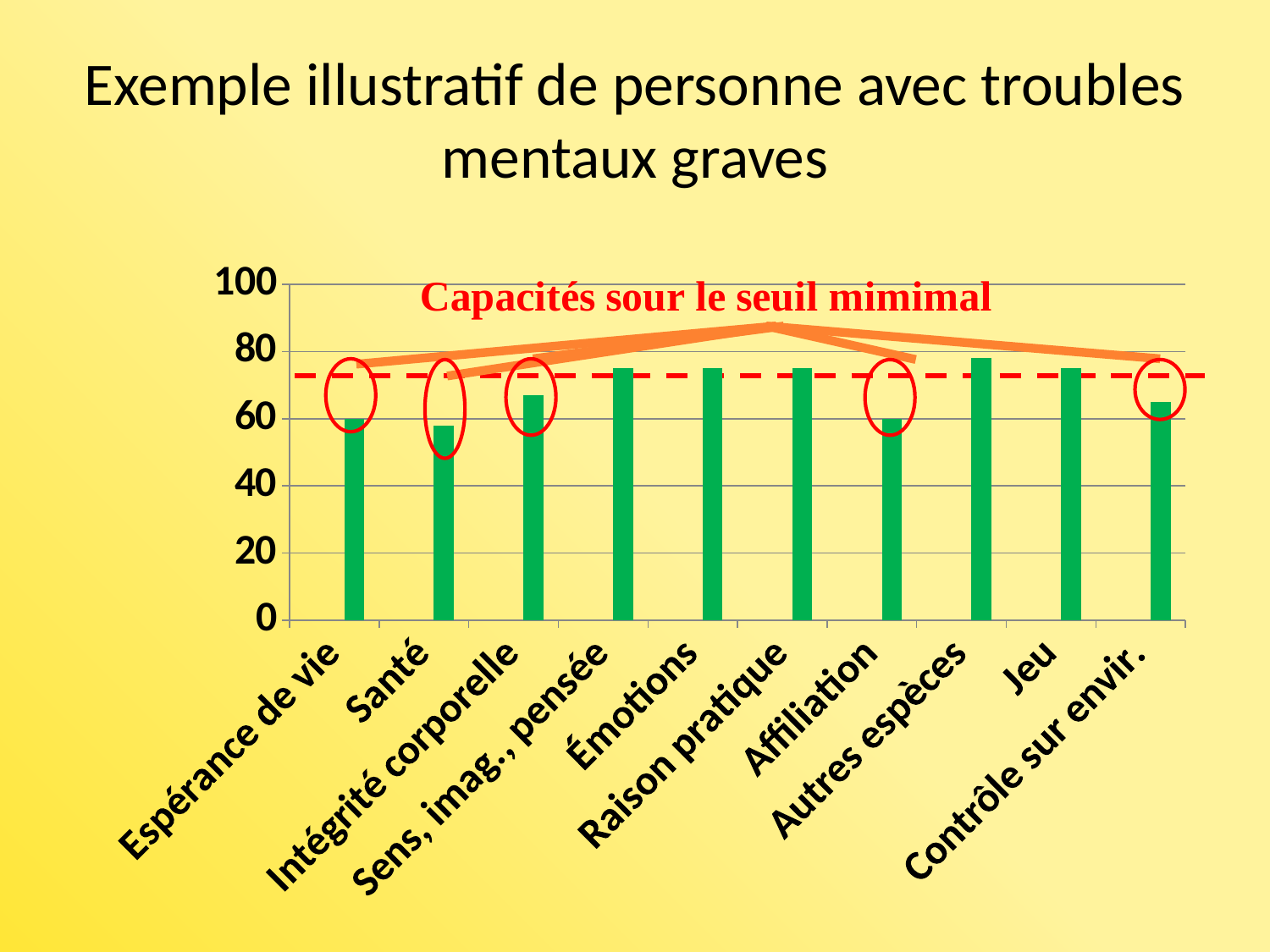
How many bars are circled in red on the chart? 5 Is the value for Autres espèces greater or less than 60? greater What kind of chart is shown on the slide? bar chart Is the value for Contrôle sur envir. greater or less than 80? less Which is larger, the value for Jeu or the value for Contrôle sur envir.? Jeu What text is written in red above the bars in the chart? Capacités sour le seuil mimimal Which is larger, the value for Intégrité corporelle or the value for Émotions? Émotions Is the value for Émotions greater or less than 80? less Which is larger, the value for Santé or the value for Autres espèces? Autres espèces How many categories are shown on the x axis of the chart? 10